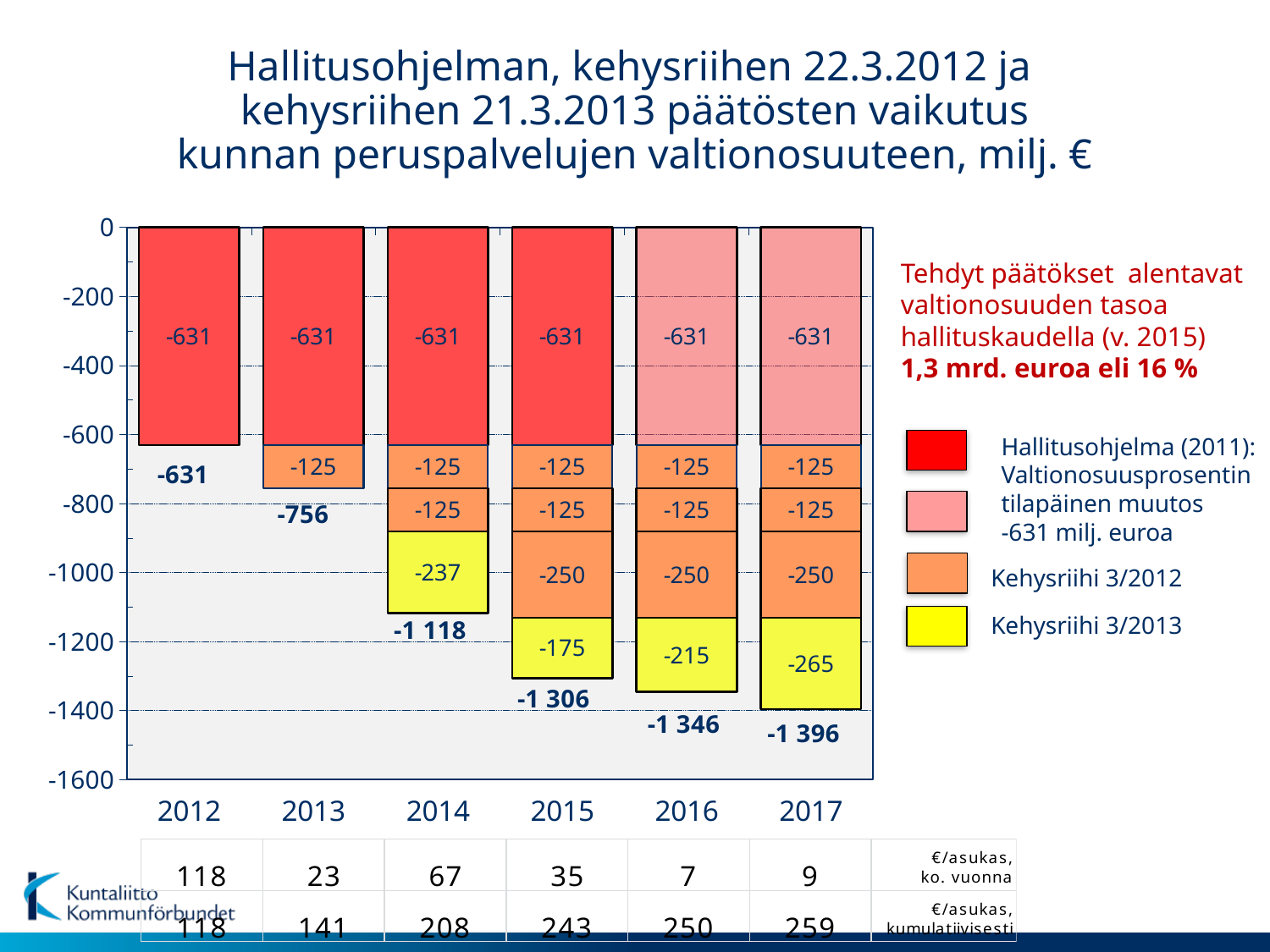
By how much does the total for 2014 differ from the total for 2013 (in absolute terms)? 362 What is the value of the Kehysriihi 3/2013 (yellow) segment for 2017? -265 What is the value of the Kehysriihi 3/2013 (yellow) segment for 2016? -215 By how much does the total for 2017 differ from the total for 2016 (in absolute terms)? 50 How many years are shown on the x axis of the chart? 6 Which year has the most negative (lowest) total? 2017 What is the total value of the stacked bar for 2017? -1 396 What kind of chart is shown on the slide? Stacked bar chart What is the total value of the stacked bar for 2015? -1 306 Do the bar totals become more negative or less negative from 2012 to 2017? More negative Which year has the least negative (highest) total? 2012 What is the value of the Hallitusohjelma (2011) segment in each year? -631